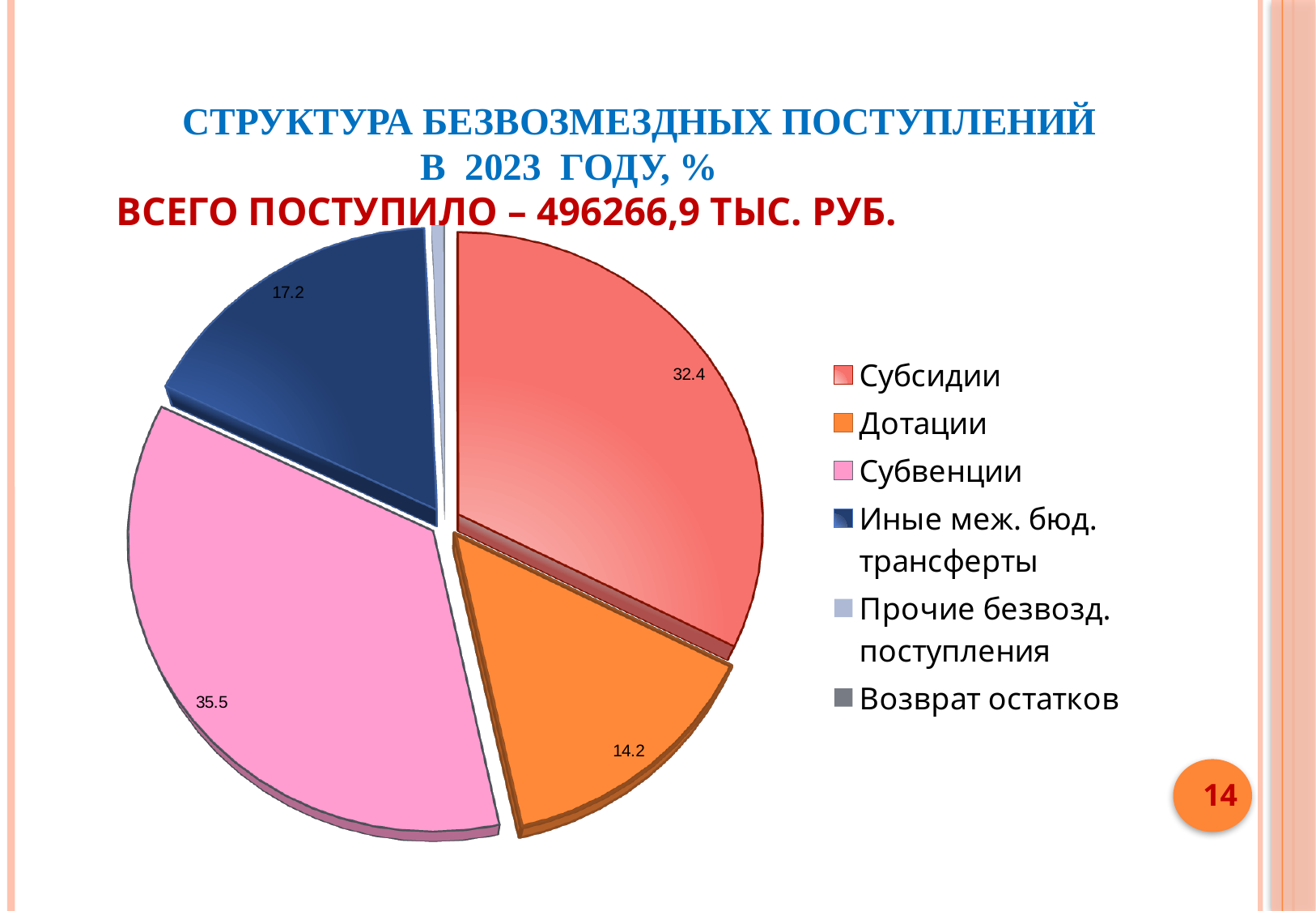
Which category has the largest slice of the pie? Субвенции What kind of chart is shown on the slide? pie chart What is the difference between the values for Субвенции and Субсидии? 3.1 What is the value shown for Субсидии? 32.4 What colour is the slice for Субвенции? pink What total amount is stated in the slide heading? 496266,9 тыс. руб. What is the value shown for Дотации? 14.2 How many entries does the legend list? 6 What is the value shown for Иные меж. бюд. трансферты? 17.2 What is the value shown for Субвенции? 35.5 Which is larger, Субсидии or Дотации? Субсидии What is the difference between the values for Иные меж. бюд. трансферты and Дотации? 3.0